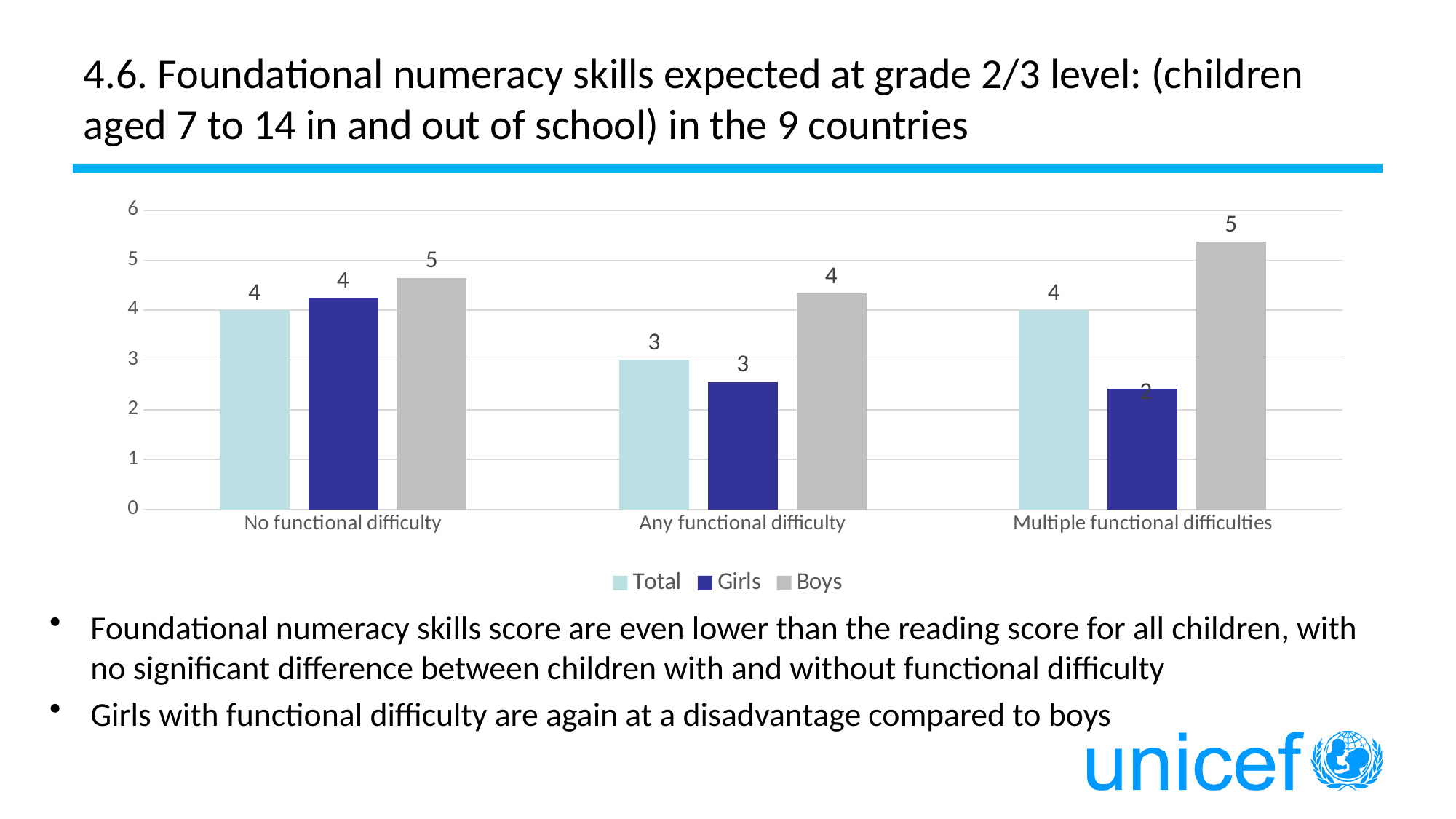
What is the value for Girls in the Multiple functional difficulties category? 2 How many categories are shown on the x axis? 3 What kind of chart is shown on the slide? Bar chart What is the value for Boys in the No functional difficulty category? 5 What is the difference between the Boys and Girls values in the Multiple functional difficulties category? 3 How many series does the legend list? 3 What is the Total value for the Any functional difficulty category? 3 Which category has the lowest value for Girls? Multiple functional difficulties Which series has the highest value in the Multiple functional difficulties category? Boys In the Multiple functional difficulties category, is the value for Girls or Boys larger? Boys